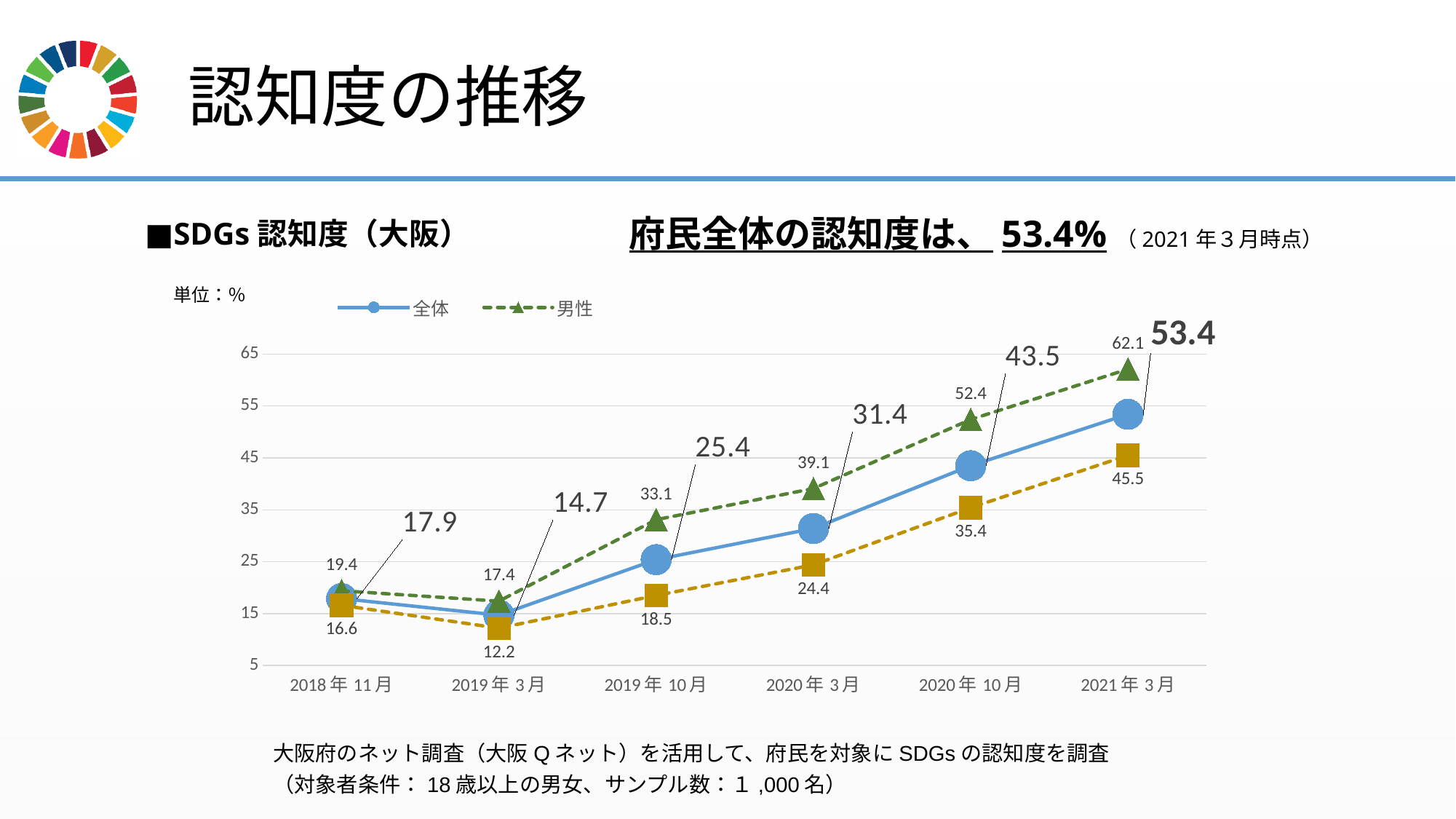
What is the value for 全体 in 2021年3月? 53.4 How many series does the legend list? 2 What is the difference between the 男性 and 全体 values in 2021年3月? 8.7 Does the 全体 value rise or fall from 2019年3月 to 2021年3月? rise What type of chart is shown on the slide? line chart What is the value for 全体 in 2019年3月? 14.7 Which is larger in 2020年3月, the 全体 value or the 男性 value? 男性 What is the value for 男性 in 2020年10月? 52.4 How many time periods are plotted on the x axis? 6 What is the value for 男性 in 2019年10月? 33.1 In which period is the 男性 value highest? 2021年3月 In which period is the 全体 value lowest? 2019年3月